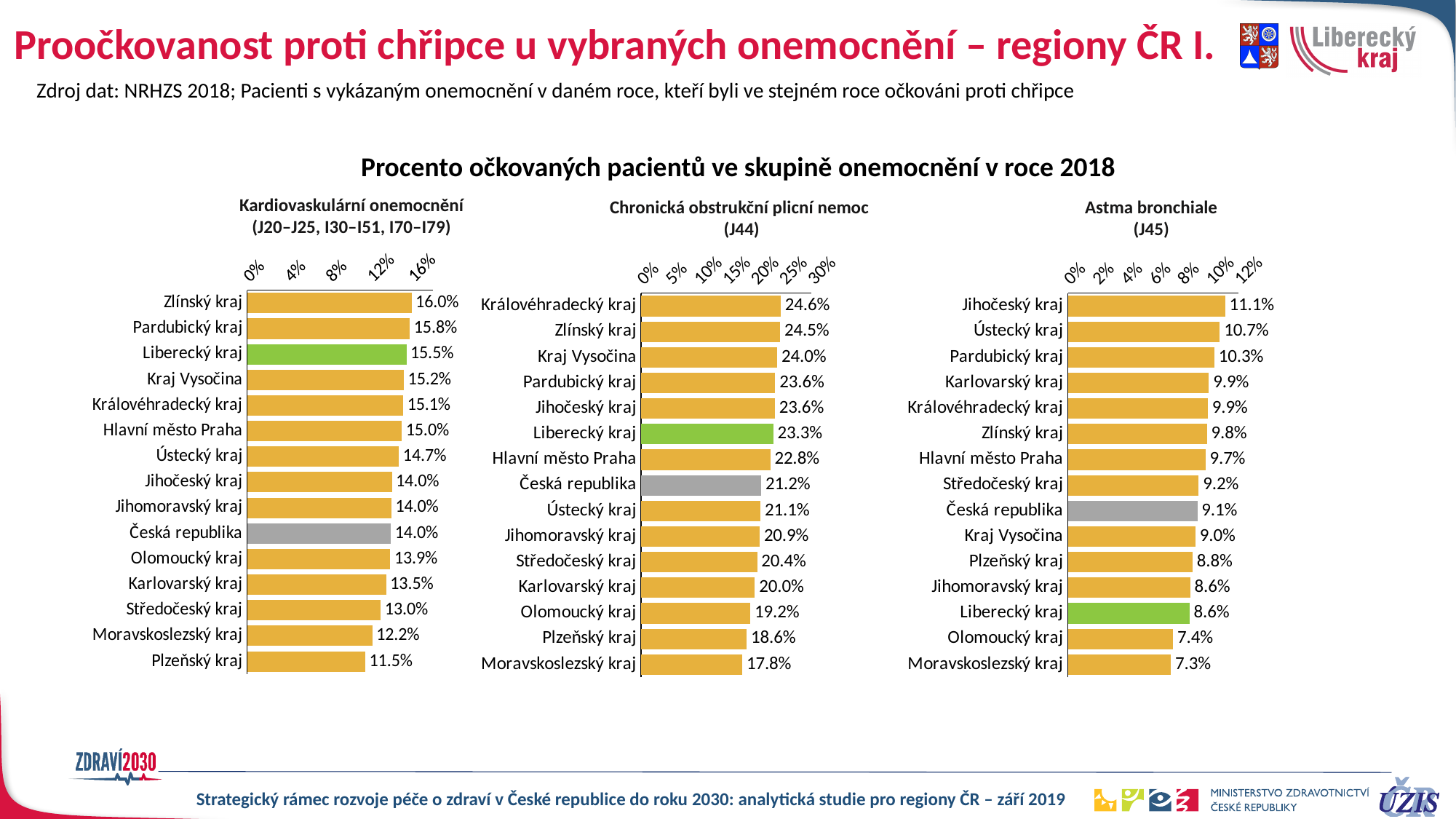
In the Kardiovaskulární onemocnění chart, what is the value for Liberecký kraj? 15.5% In the Chronická obstrukční plicní nemoc chart, which is larger: Liberecký kraj or Hlavní město Praha? Liberecký kraj In the Chronická obstrukční plicní nemoc chart, what is the value for Česká republika? 21.2% In the Chronická obstrukční plicní nemoc chart, which region has the lowest value? Moravskoslezský kraj In the Astma bronchiale chart, which region has the highest value? Jihočeský kraj In the Kardiovaskulární onemocnění chart, what is the difference between Zlínský kraj and Plzeňský kraj? 4.5% In the Kardiovaskulární onemocnění chart, which region has the lowest value? Plzeňský kraj What type of chart is the Astma bronchiale chart? Bar chart In the Kardiovaskulární onemocnění chart, which region has the highest value? Zlínský kraj In the Chronická obstrukční plicní nemoc chart, which region has the highest value? Královéhradecký kraj How many bars are shown in the Astma bronchiale chart? 15 In the Astma bronchiale chart, what is the value for Liberecký kraj? 8.6%